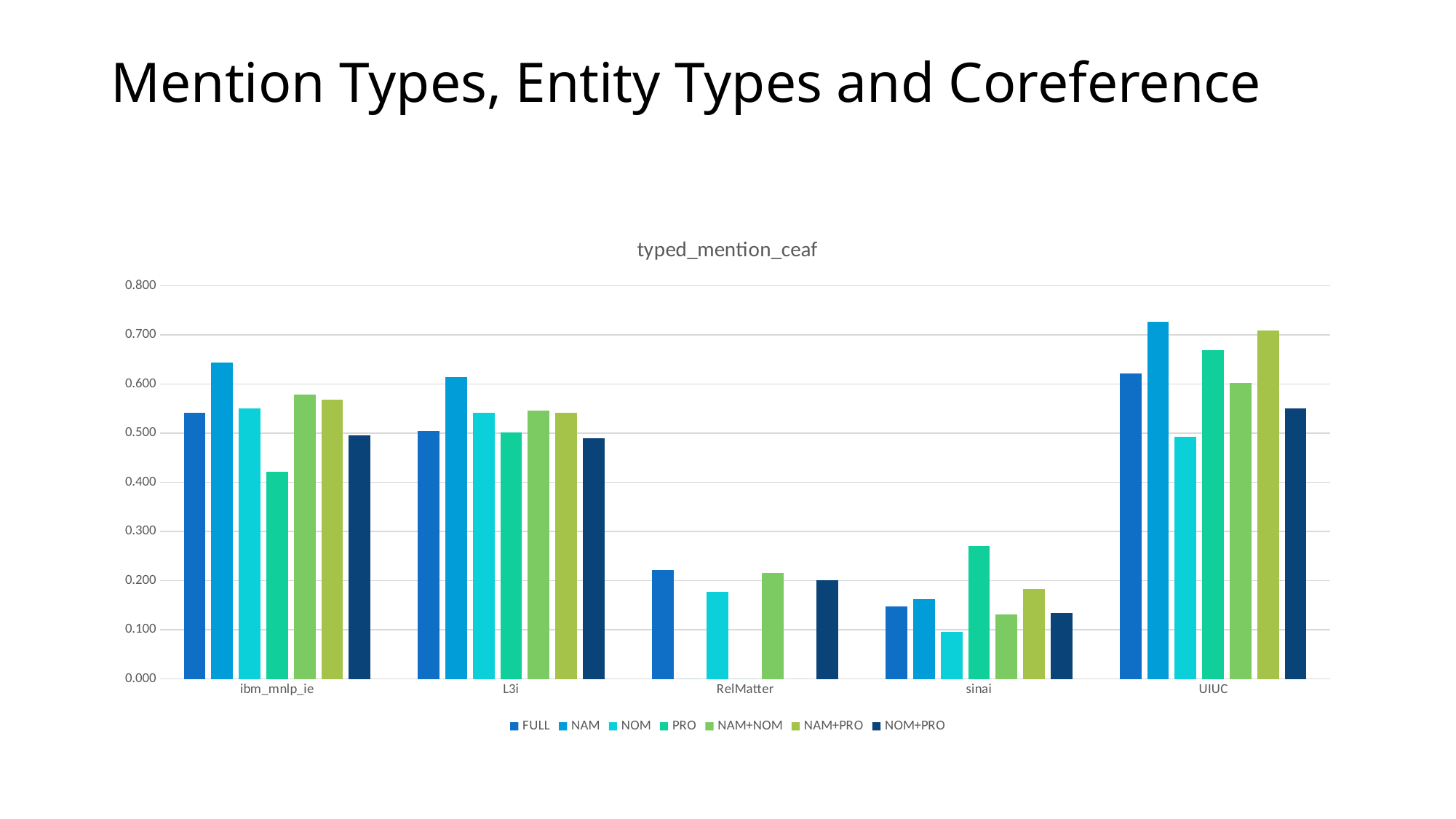
What kind of chart is shown on the slide? bar chart For L3i, which is larger: the NAM value or the FULL value? NAM Is the NAM value for UIUC greater or less than 0.700? greater What is the title of the chart? typed_mention_ceaf Is the PRO value for ibm_mnlp_ie greater or less than 0.500? less How many categories are shown along the x axis? 5 How many series does the legend list? 7 Which category has the highest NAM value? UIUC Which category has the lowest FULL value? sinai Is the NAM value for ibm_mnlp_ie greater or less than 0.600? greater For sinai, which is larger: the PRO value or the NOM value? PRO